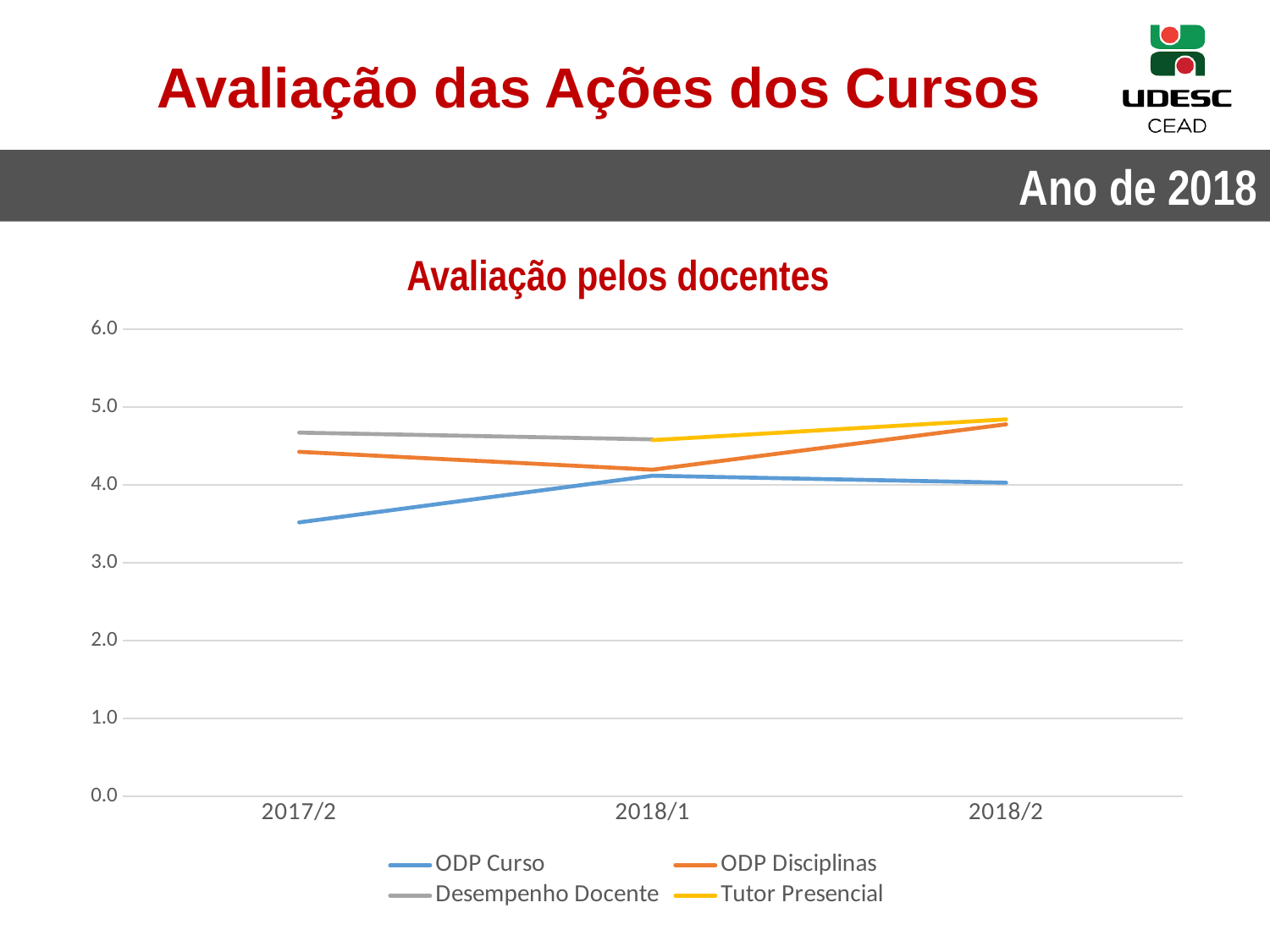
What is the title of the chart? Avaliação pelos docentes Does the ODP Curso line rise or fall from 2017/2 to 2018/1? rise Which series has the highest value in 2017/2? Desempenho Docente What kind of chart is shown on the slide? line chart Which series has the lowest value in 2017/2? ODP Curso Is the value for ODP Curso in 2017/2 greater or less than 4.0? less In 2018/2, which is larger: ODP Disciplinas or ODP Curso? ODP Disciplinas How many periods are shown on the x axis? 3 Is the value for Desempenho Docente in 2017/2 greater or less than 4.0? greater How many series does the legend list? 4 Is the value for ODP Disciplinas in 2018/2 greater or less than 4.0? greater